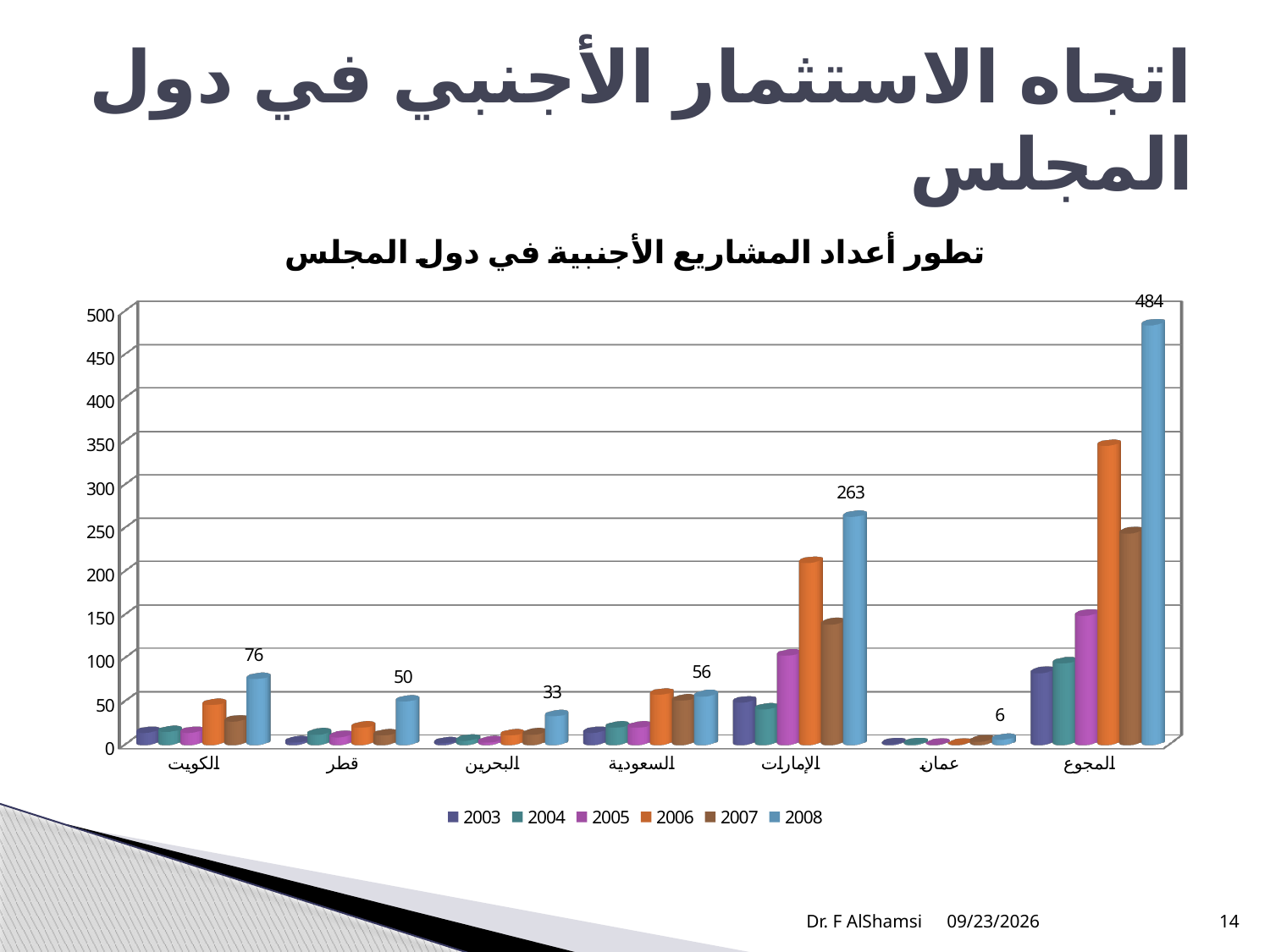
How many categories are shown on the x axis? 7 Which category has the lowest 2008 value? عمان Which country (excluding المجموع) has the highest 2008 value? الإمارات What is the 2008 value for الإمارات? 263 What is the 2008 value for عمان? 6 What is the 2008 value for الكويت? 76 How many series does the legend list? 6 Is the 2006 value for الإمارات greater or less than 150? greater What type of chart is shown on the slide? bar chart What is the 2008 value for المجموع? 484 Which is larger, the 2008 value for قطر or the 2008 value for البحرين? قطر What is the difference between the 2008 values for الإمارات and السعودية? 207